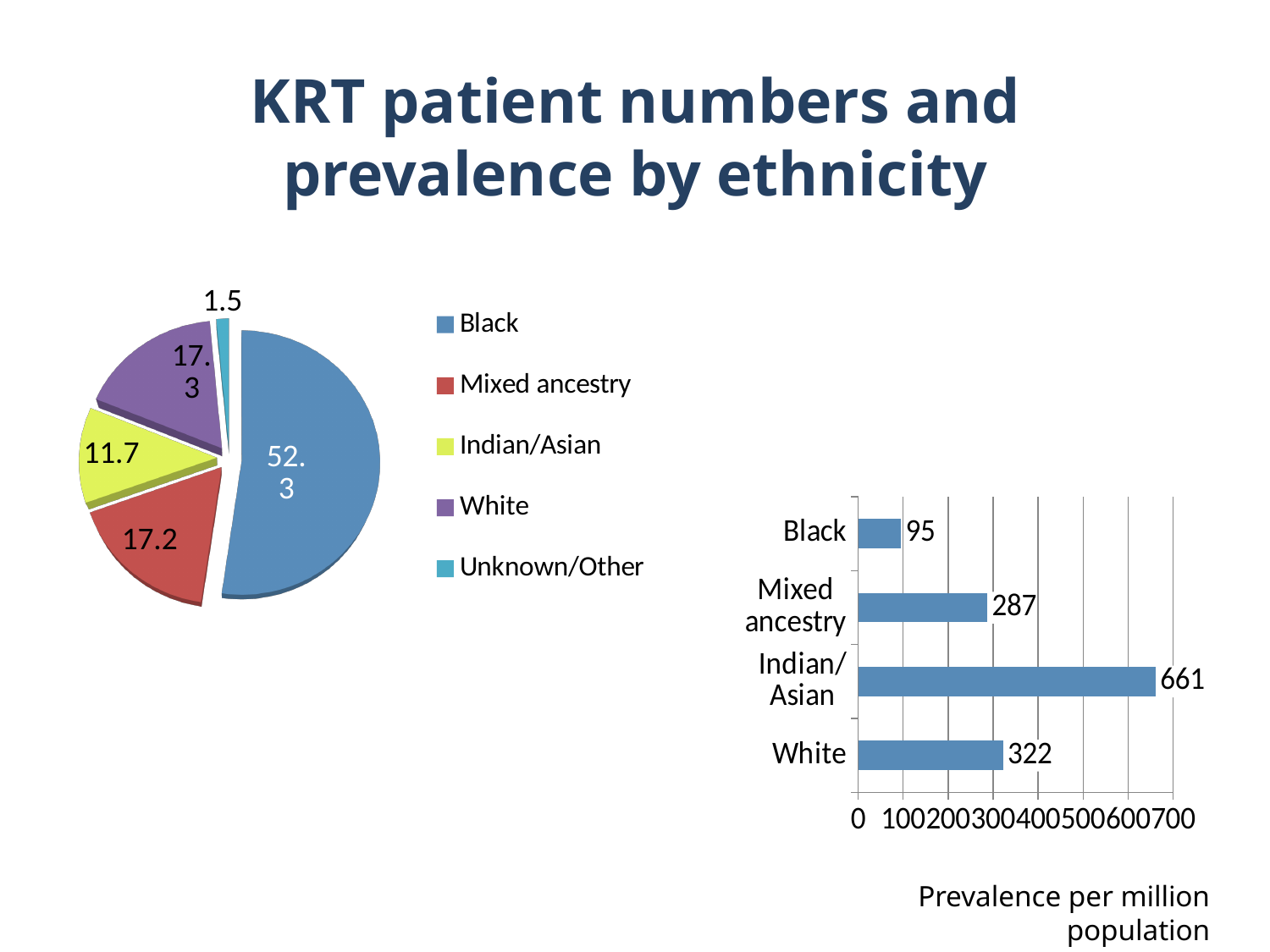
In the bar chart on the right, what is the prevalence per million population for Indian/Asian? 661 In the bar chart on the right, which ethnicity has the lowest prevalence per million population? Black How many categories does the legend of the pie chart on the left list? 5 In the pie chart on the left, what is the difference between the White value and the Mixed ancestry value? 0.1 In the bar chart on the right, what is the prevalence per million population for Black? 95 In the bar chart on the right, which is larger: the value for White or the value for Mixed ancestry? White In the bar chart on the right, what is the difference in prevalence between White and Mixed ancestry? 35 In the pie chart on the left, which category has the smallest slice? Unknown/Other In the pie chart on the left, which category has the largest slice? Black What kind of chart is the chart on the right of the slide? Bar chart In the pie chart on the left, what is the value shown for the Black slice? 52.3 In the pie chart on the left, what is the value shown for the Indian/Asian slice? 11.7